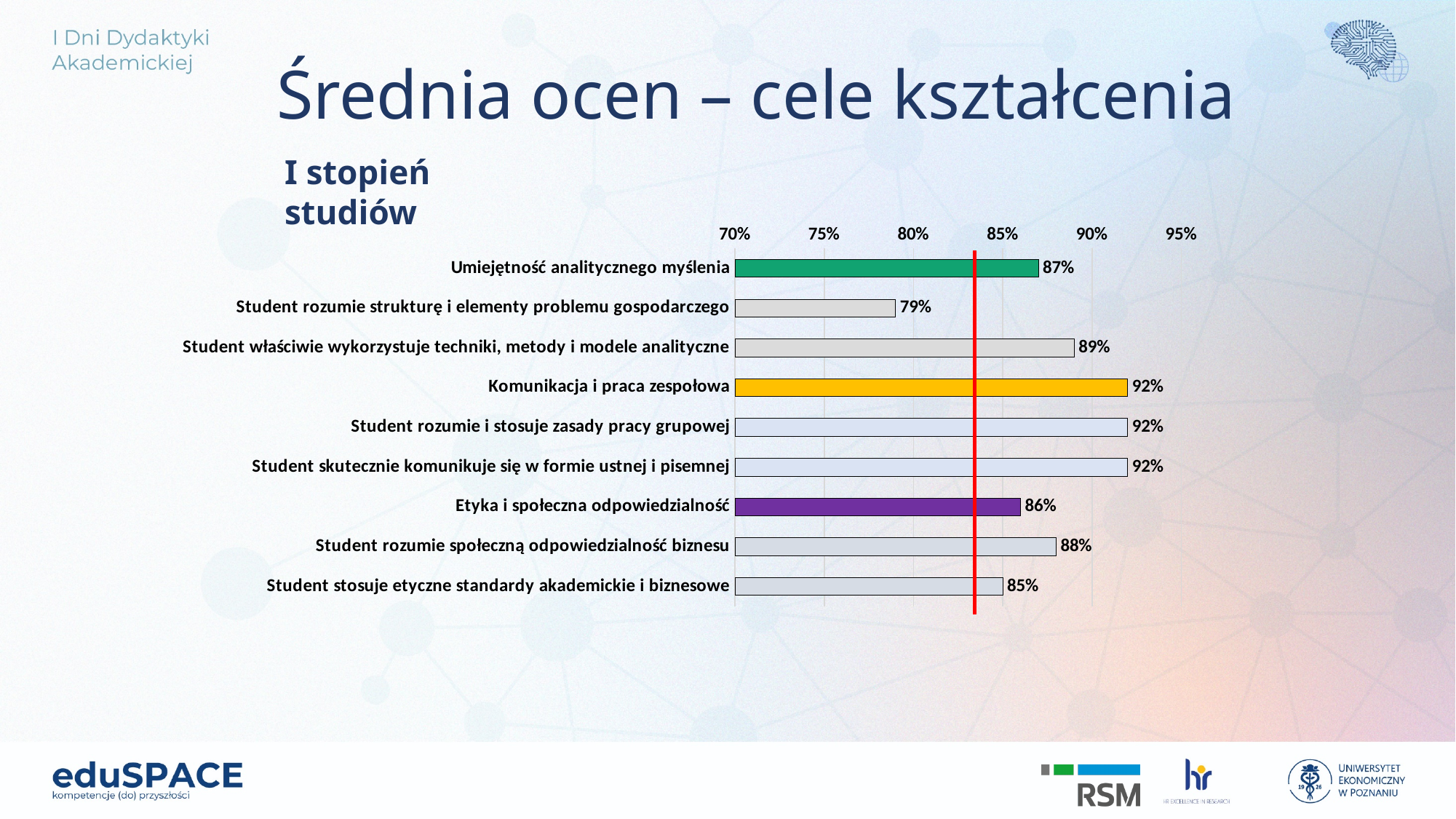
Is the value for "Student rozumie strukturę i elementy problemu gospodarczego" greater or less than 80%? less What is the highest value shown in the chart? 92% What is the value for "Etyka i społeczna odpowiedzialność"? 86% What is the difference between "Student właściwie wykorzystuje techniki, metody i modele analityczne" and "Student rozumie strukturę i elementy problemu gospodarczego"? 10% Which category has the lowest value? Student rozumie strukturę i elementy problemu gospodarczego What type of chart is shown on the slide? bar chart What is the value for "Umiejętność analitycznego myślenia"? 87% Which is larger: the value for "Student rozumie społeczną odpowiedzialność biznesu" or for "Etyka i społeczna odpowiedzialność"? Student rozumie społeczną odpowiedzialność biznesu What is the value for "Komunikacja i praca zespołowa"? 92% How many categories are plotted in the chart? 9 What is the title of the slide containing the chart? Średnia ocen – cele kształcenia What is the value for "Student stosuje etyczne standardy akademickie i biznesowe"? 85%